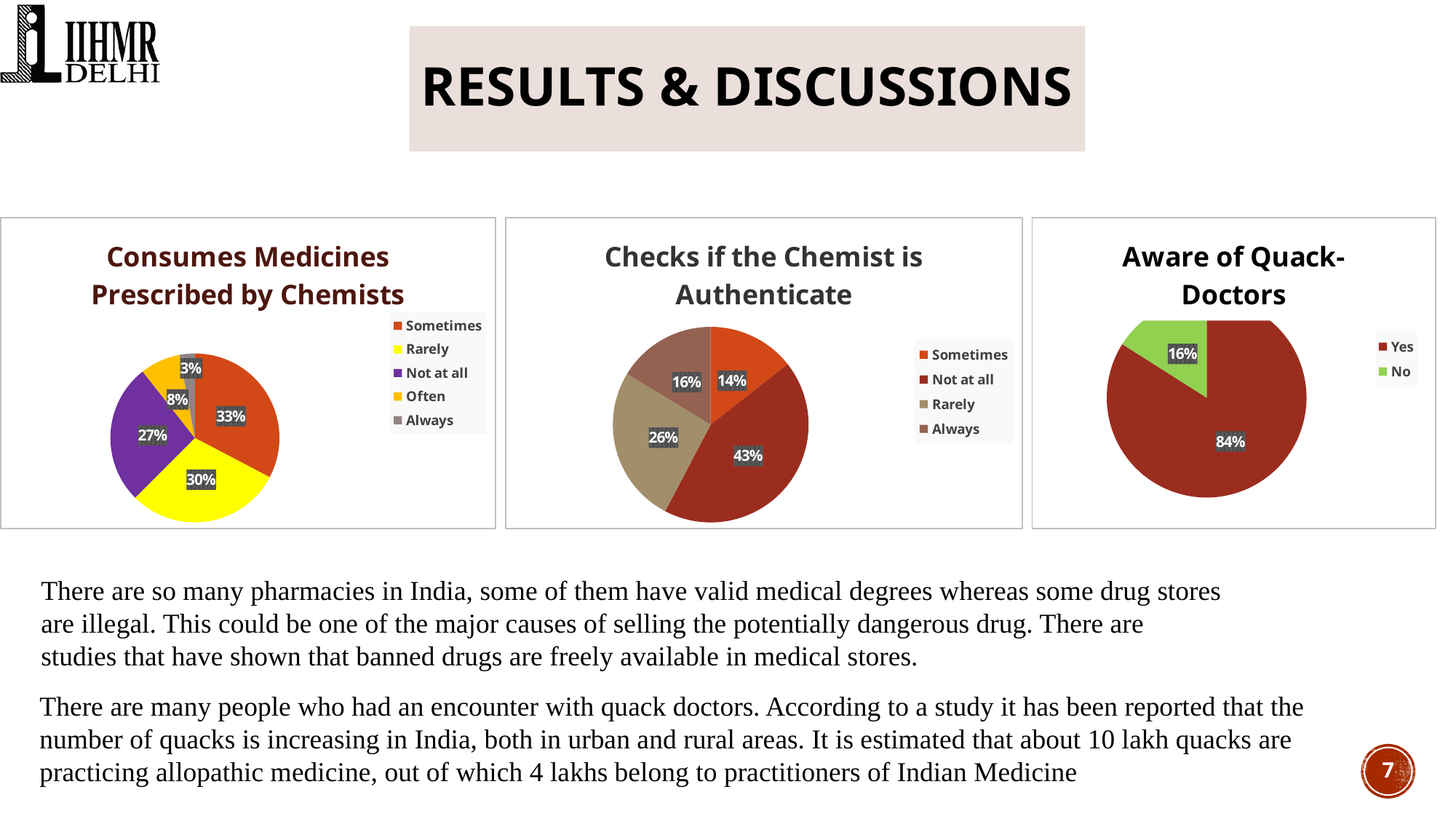
In the 'Consumes Medicines Prescribed by Chemists' chart, which category has the smallest share? Always In the 'Consumes Medicines Prescribed by Chemists' chart, what is the difference between the Rarely and Not at all shares? 3% In the 'Checks if the Chemist is Authenticate' chart, which is larger: Rarely or Always? Rarely In the 'Consumes Medicines Prescribed by Chemists' chart, how many categories does the legend list? 5 In the 'Aware of Quack-Doctors' chart, what colour represents No? Green In the 'Aware of Quack-Doctors' chart, what percentage answered Yes? 84% In the 'Checks if the Chemist is Authenticate' chart, what is the difference between the Not at all and Sometimes shares? 29% In the 'Aware of Quack-Doctors' chart, what is the difference between the Yes and No shares? 68% In the 'Checks if the Chemist is Authenticate' chart, what percentage is shown for Not at all? 43% What type of chart is used for 'Aware of Quack-Doctors'? Pie chart In the 'Consumes Medicines Prescribed by Chemists' chart, what percentage is shown for Sometimes? 33% In the 'Checks if the Chemist is Authenticate' chart, which category has the largest share? Not at all